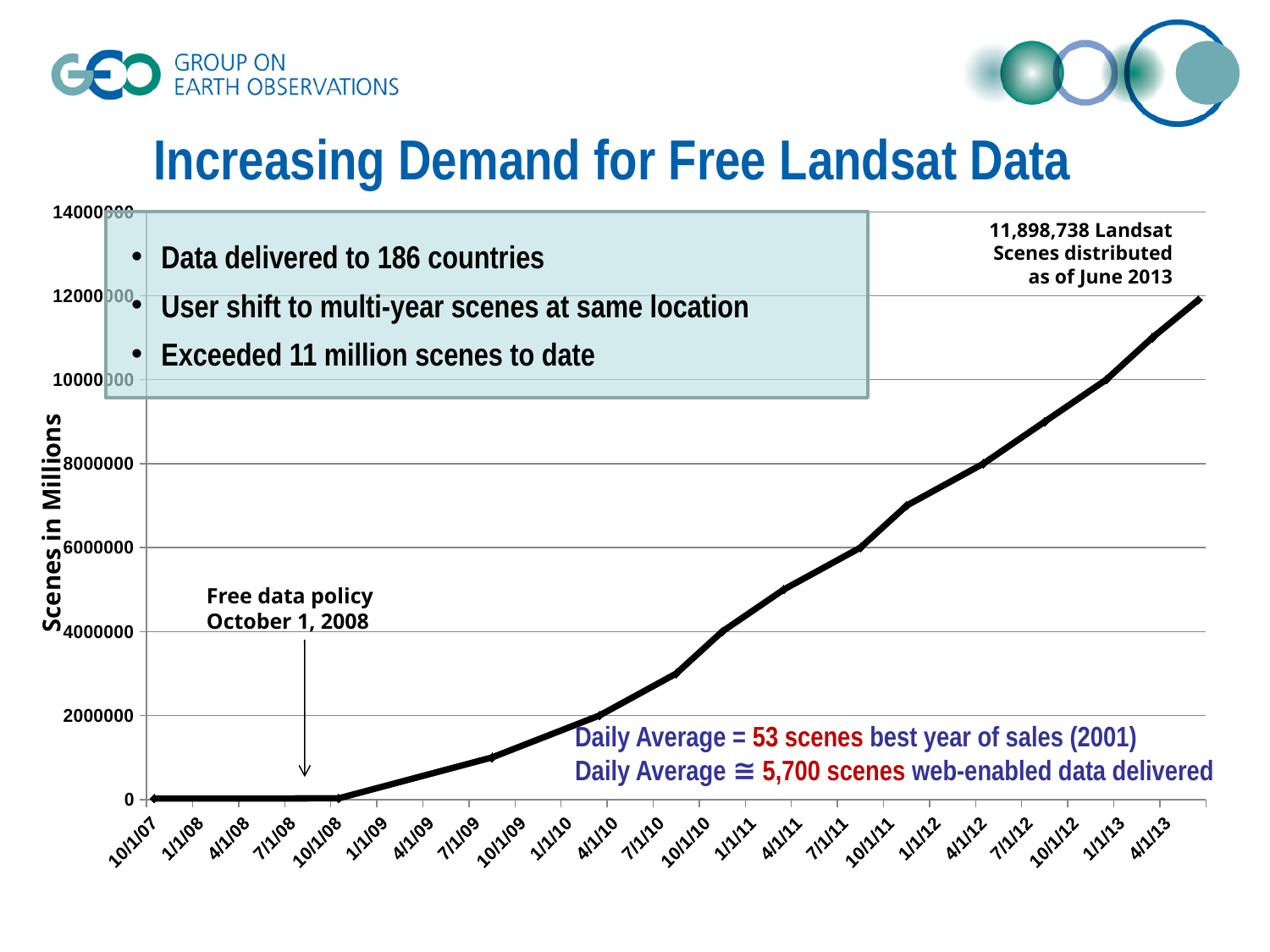
According to the annotation on the chart, how many Landsat scenes had been distributed as of June 2013? 11,898,738 Is the value for 4/1/13 greater or less than 10000000? greater What kind of chart is shown on the slide? line chart Is the value for 10/1/09 greater or less than 2000000? less How many date labels are shown on the x axis? 23 Is the value for 7/1/10 greater or less than 4000000? less Do the values rise or fall along the x axis from 10/1/07 to 4/1/13? rise What is the title of the y axis? Scenes in Millions Which is larger, the value for 4/1/11 or the value for 1/1/10? 4/1/11